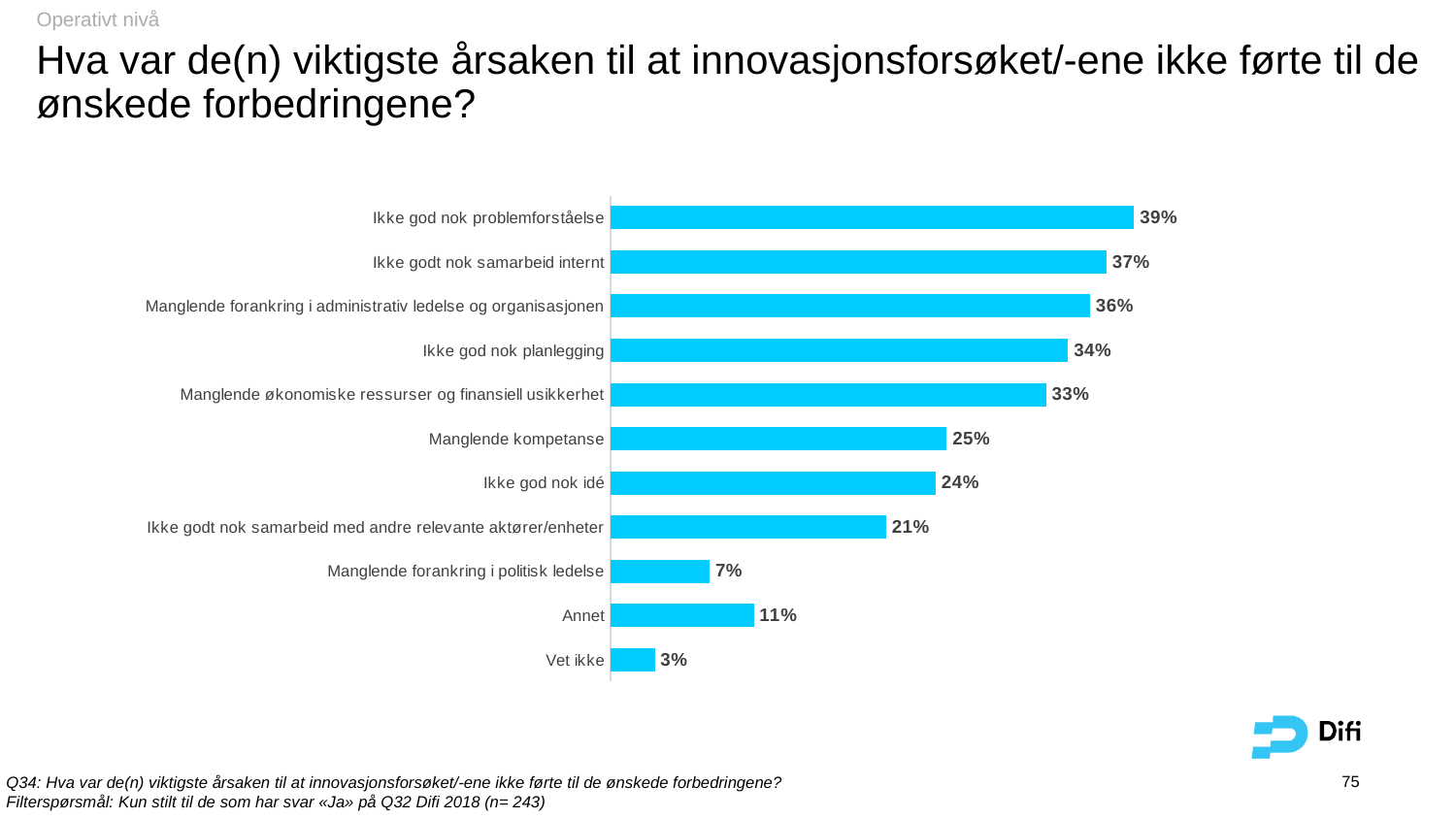
What kind of chart is shown on the slide? Bar chart What is the value for "Manglende kompetanse"? 25% What colour are the bars in the chart? Light blue How many categories are shown in the chart? 11 Which category has the lowest value? Vet ikke What is the value for "Annet"? 11% What is the value for "Manglende forankring i politisk ledelse"? 7% Which is larger: "Manglende økonomiske ressurser og finansiell usikkerhet" or "Manglende kompetanse"? Manglende økonomiske ressurser og finansiell usikkerhet What is the value for "Ikke god nok problemforståelse"? 39% What is the difference between "Ikke god nok planlegging" and "Ikke god nok idé"? 10% What is the difference between "Ikke godt nok samarbeid internt" and "Ikke godt nok samarbeid med andre relevante aktører/enheter"? 16% Which category has the highest value? Ikke god nok problemforståelse